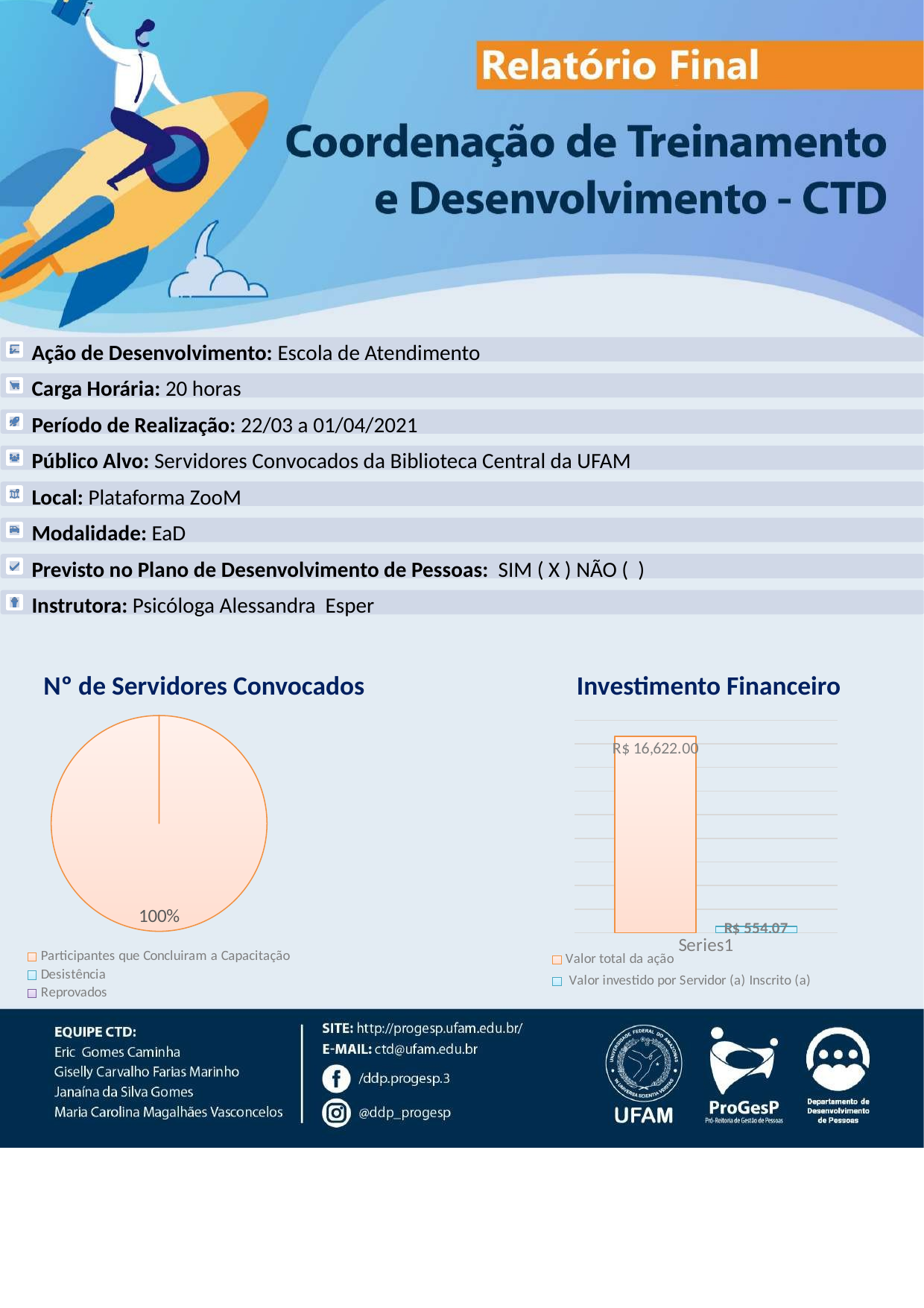
In the 'Nº de Servidores Convocados' chart, which legend entry does the single visible slice correspond to? Participantes que Concluiram a Capacitação In the 'Investimento Financeiro' chart, which series has the higher value? Valor total da ação In the 'Investimento Financeiro' chart, what is the value for 'Valor total da ação'? R$ 16,622.00 In the 'Nº de Servidores Convocados' chart, what share of the pie is labelled on the slice? 100% In the 'Investimento Financeiro' chart, which series has the lower value? Valor investido por Servidor (a) Inscrito (a) In the 'Investimento Financeiro' chart, what is the category label shown on the x axis? Series1 In the 'Investimento Financeiro' chart, what is the value for 'Valor investido por Servidor (a) Inscrito (a)'? R$ 554.07 How many series does the legend of the 'Investimento Financeiro' chart list? 2 What kind of chart is the 'Investimento Financeiro' chart? bar chart In the 'Investimento Financeiro' chart, what is the difference between 'Valor total da ação' and 'Valor investido por Servidor (a) Inscrito (a)'? R$ 16,067.93 How many entries does the legend of the 'Nº de Servidores Convocados' chart list? 3 What kind of chart is the 'Nº de Servidores Convocados' chart? pie chart